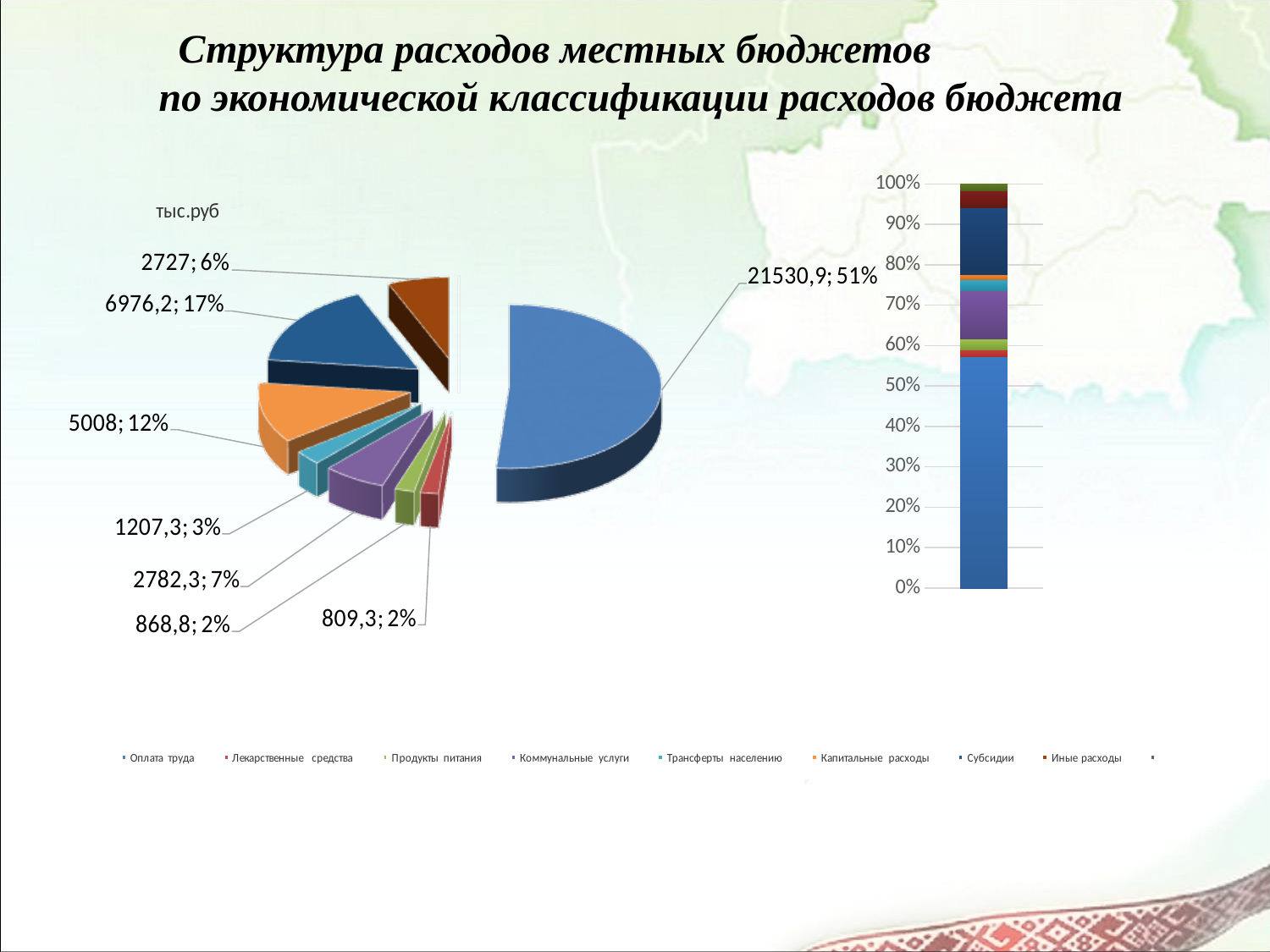
In the pie chart on the left, what percentage share does the slice with value 2782,3 have? 7% In the pie chart on the left, what percentage share does the largest slice have? 51% What kind of chart is the chart on the left of the slide? pie chart In the pie chart on the left, which is larger: the slice labelled 2727 or the slice labelled 2782,3? 2782,3 In the pie chart on the left, what is the value of the largest slice? 21530,9 How many slices does the pie chart on the left have? 8 In the pie chart on the left, what percentage share does the slice with value 5008 have? 12% In the stacked bar chart on the right, is the top of the bottom (blue) segment greater or less than 50%? greater What unit is shown above the pie chart on the left? тыс.руб In the pie chart on the left, what is the value of the smallest slice? 809,3 What kind of chart is the chart on the right of the slide? bar chart In the pie chart on the left, what is the difference between the slice labelled 6976,2 and the slice labelled 5008? 1968,2